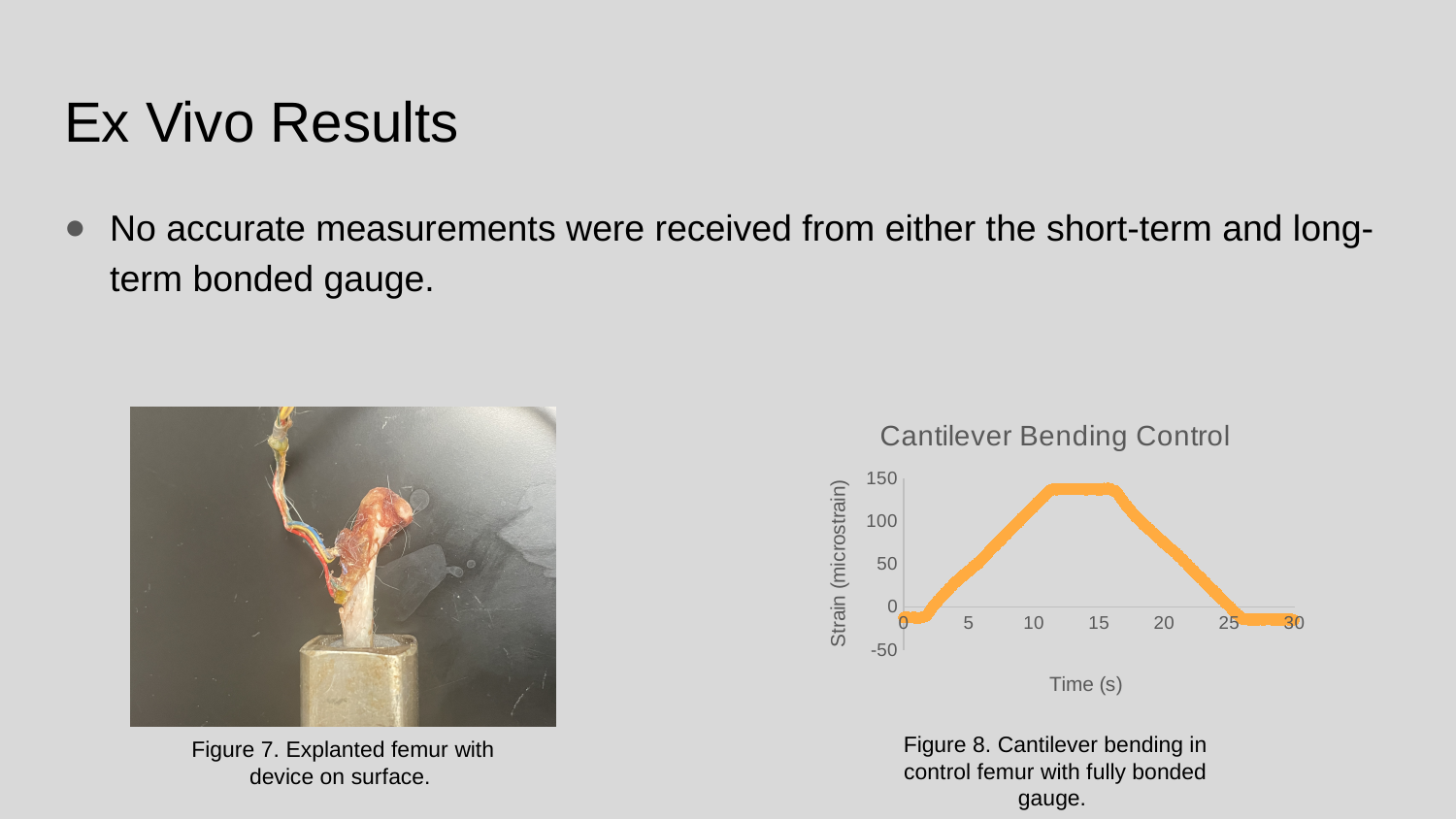
On the Cantilever Bending Control chart, is the peak strain greater or less than 150? less On the Cantilever Bending Control chart, is the strain at 20 s greater or less than 50? greater On the Cantilever Bending Control chart, does the strain rise or fall between 0 s and 10 s? rise On the Cantilever Bending Control chart, is the strain at 5 s greater or less than 100? less What kind of chart is the Cantilever Bending Control chart? line chart What is the label of the y axis on the Cantilever Bending Control chart? Strain (microstrain) On the Cantilever Bending Control chart, does the strain rise or fall between 17 s and 25 s? fall On the Cantilever Bending Control chart, is the strain at 15 s larger or smaller than the strain at 25 s? larger What is the title of the chart on the slide? Cantilever Bending Control